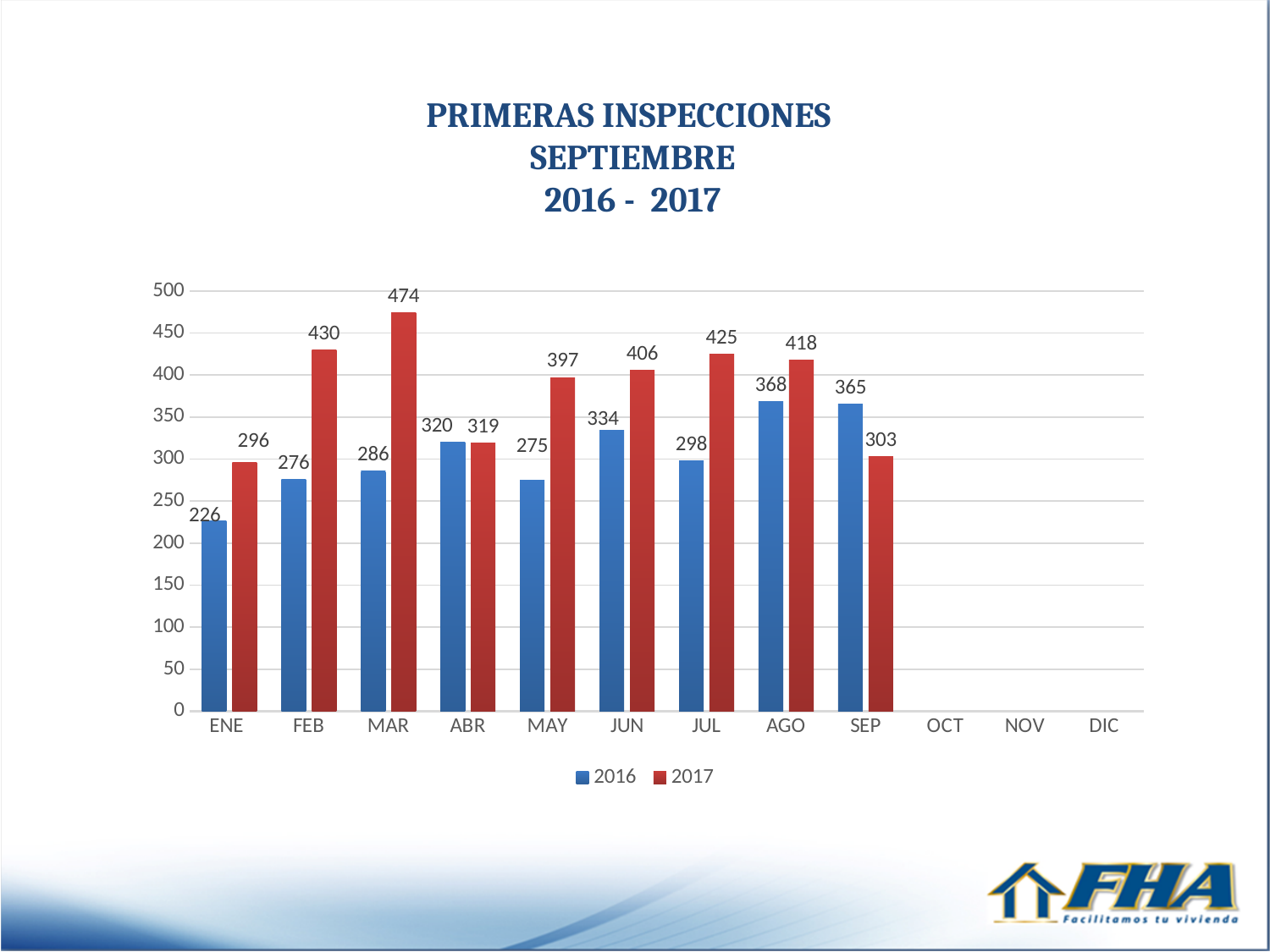
What is the value for 2016 in AGO? 368 Which month has the lowest value for the 2016 series? ENE How many months have data plotted for both series? 9 What is the difference between the 2017 and 2016 values in FEB? 154 Is the value for 2017 in JUL greater or less than 400? greater Which is larger in SEP, the 2016 value or the 2017 value? 2016 How many series does the legend list? 2 Which month has the highest value for the 2017 series? MAR What kind of chart is shown on the slide? bar chart What is the title of the chart? PRIMERAS INSPECCIONES SEPTIEMBRE 2016 - 2017 What is the value for 2017 in MAR? 474 What is the value for 2016 in ENE? 226